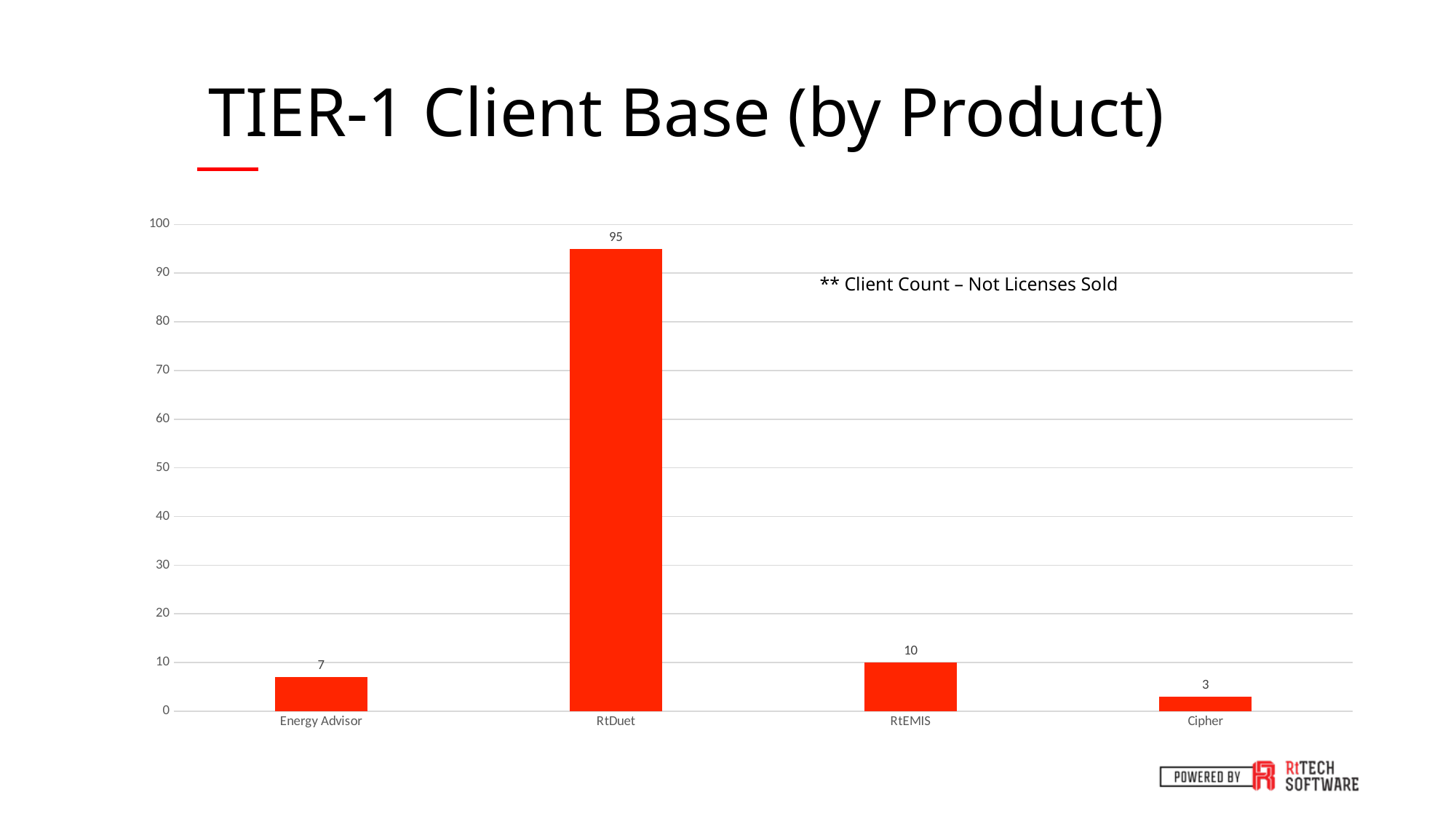
What is the value for Cipher? 3 Which product has the lowest value? Cipher What is the difference between the values for RtDuet and RtEMIS? 85 What is the value for RtDuet? 95 What kind of chart is shown on the slide? Bar chart What is the difference between the values for Energy Advisor and Cipher? 4 What is the value for Energy Advisor? 7 Which product has the highest value? RtDuet Which is larger, the value for RtEMIS or the value for Energy Advisor? RtEMIS How many products are shown on the chart? 4 Is the value for RtDuet greater or less than 90? greater What is the value for RtEMIS? 10